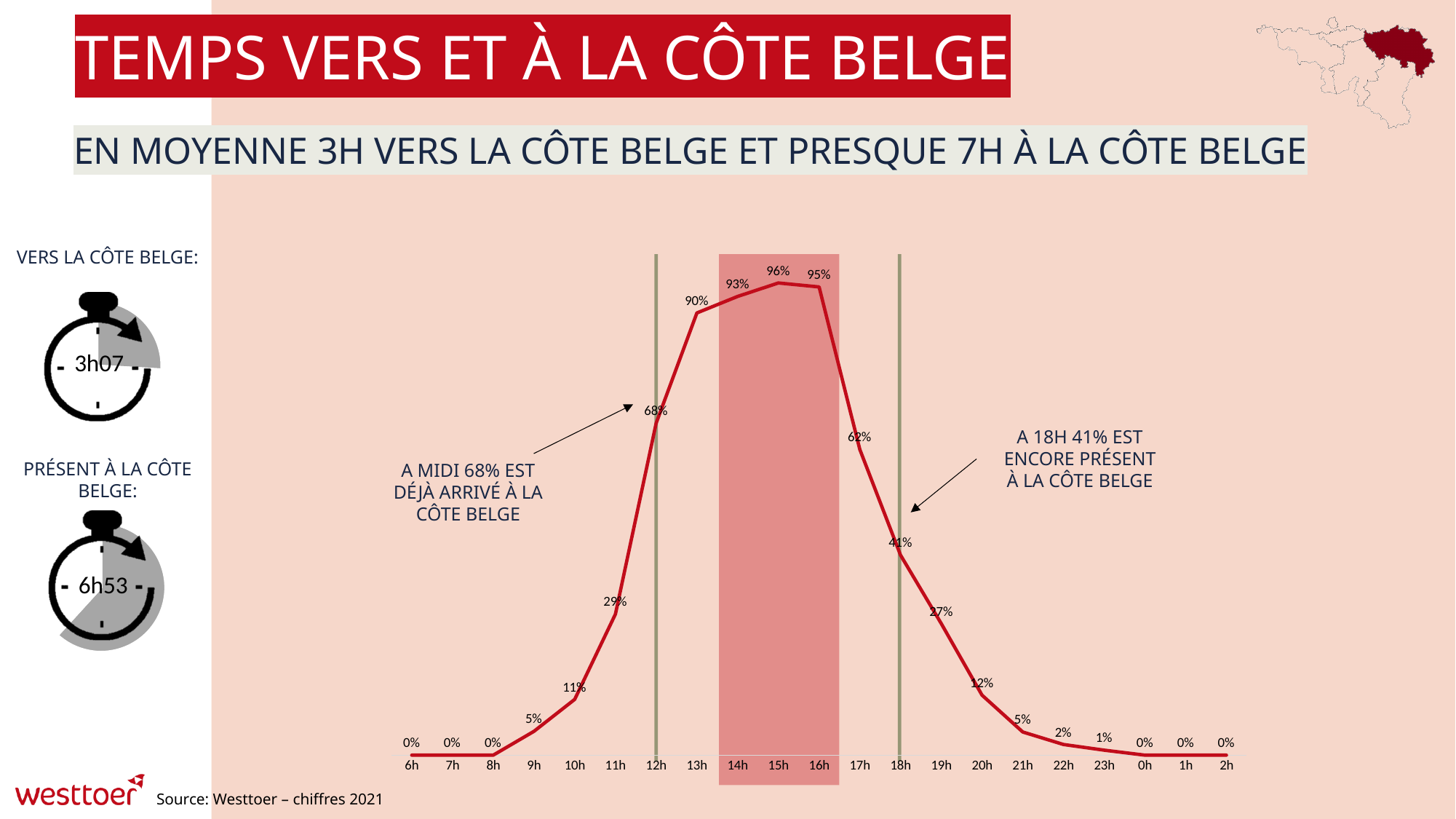
Which is larger, the value at 14h or the value at 16h? 16h What is the value shown at 20h? 12% What is the highest value shown on the chart? 96% What kind of chart is shown on the slide? line chart How many hourly points are plotted on the chart? 21 Do the values rise or fall between 16h and 2h? fall What is the difference between the values at 12h and 18h? 27% What is the difference between the values at 13h and 17h? 28% What is the value shown at 12h? 68% What is the value shown at 18h? 41% What is the value shown at 11h? 29% At which hour is the value highest? 15h